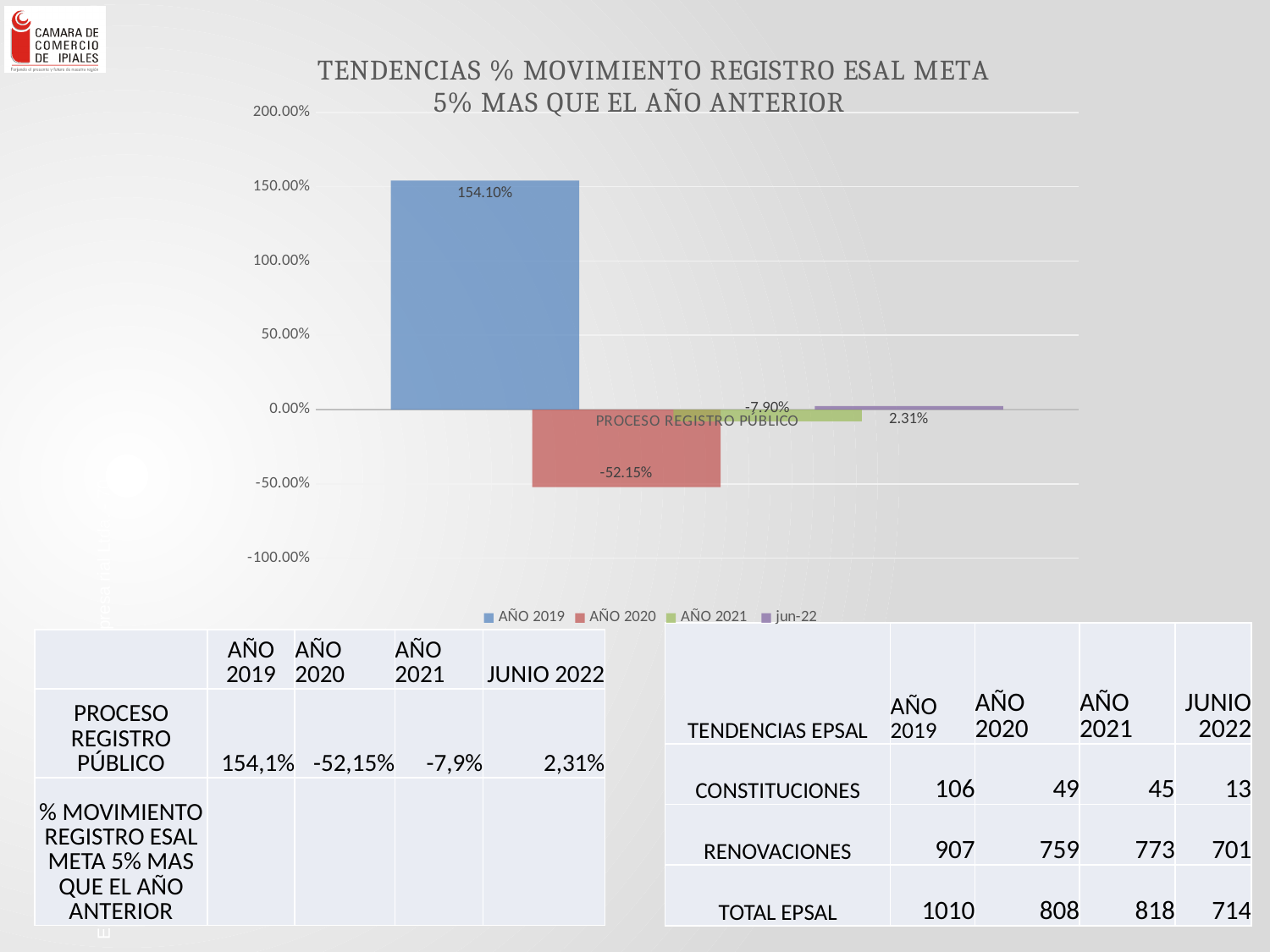
How many series does the chart legend list? 4 What type of chart is shown on the slide? bar chart What is the value for AÑO 2020 in the chart? -52.15% Which series has the highest value in the chart? AÑO 2019 What is the value for AÑO 2021 in the chart? -7.90% What category label is shown on the x axis of the chart? PROCESO REGISTRO PÚBLICO Which is larger in the chart, the value for AÑO 2021 or the value for jun-22? jun-22 Which series has the lowest value in the chart? AÑO 2020 Is the value for AÑO 2019 greater or less than 150.00%? greater What is the difference between the AÑO 2019 value and the jun-22 value in the chart? 151.79% What is the value for AÑO 2019 in the chart? 154.10% What is the value for jun-22 in the chart? 2.31%